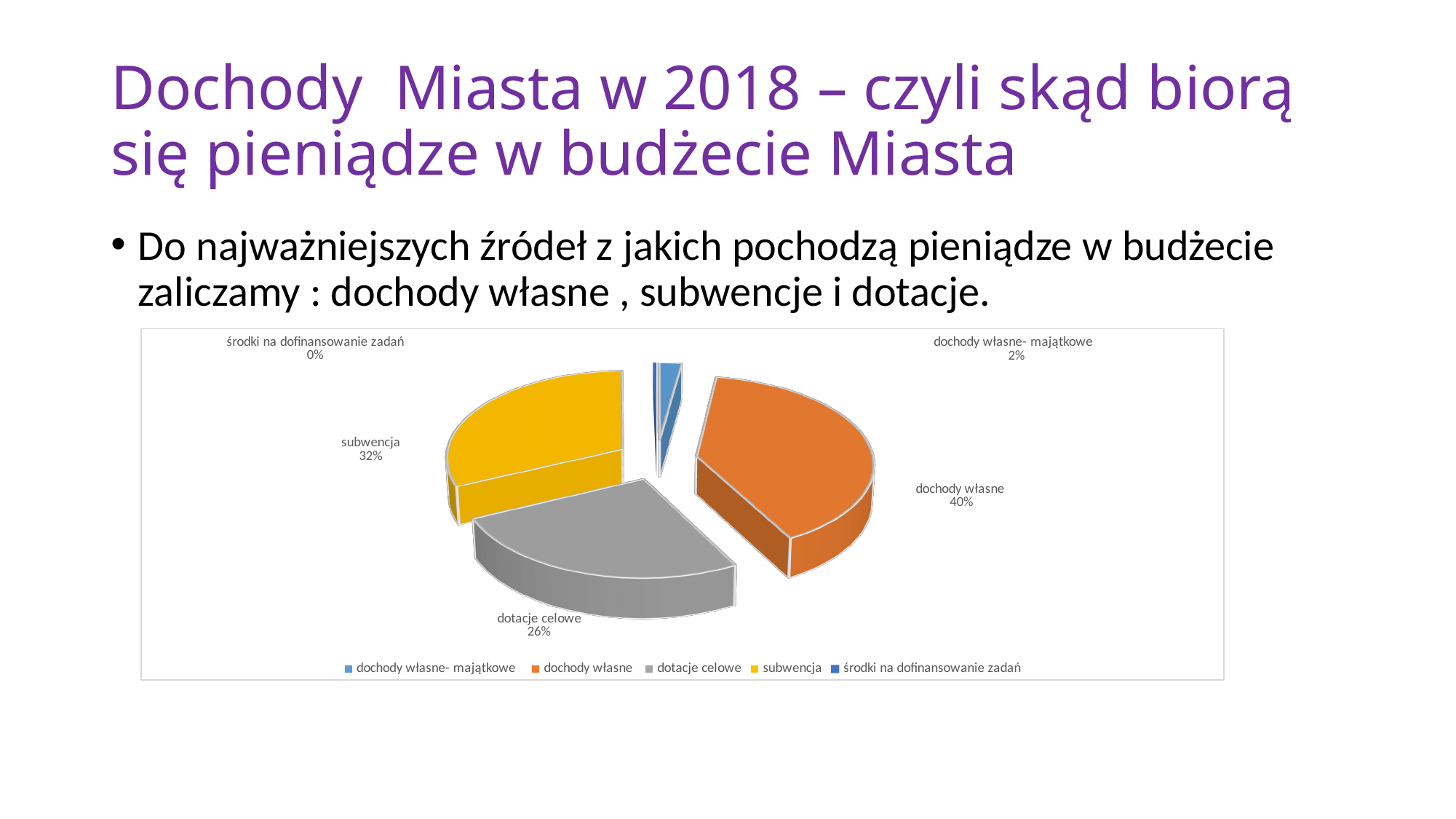
Which category has the largest share of the pie? dochody własne What share of the pie does 'subwencja' have? 32% What share of the pie does 'dotacje celowe' have? 26% What share of the pie does 'środki na dofinansowanie zadań' have? 0% What kind of chart is shown on the slide? pie chart Which is larger, the share for 'subwencja' or the share for 'dotacje celowe'? subwencja How many categories does the legend list? 5 What colour is the slice for 'dotacje celowe'? grey Which category has the smallest share of the pie? środki na dofinansowanie zadań What is the difference in percentage points between 'dochody własne' and 'subwencja'? 8